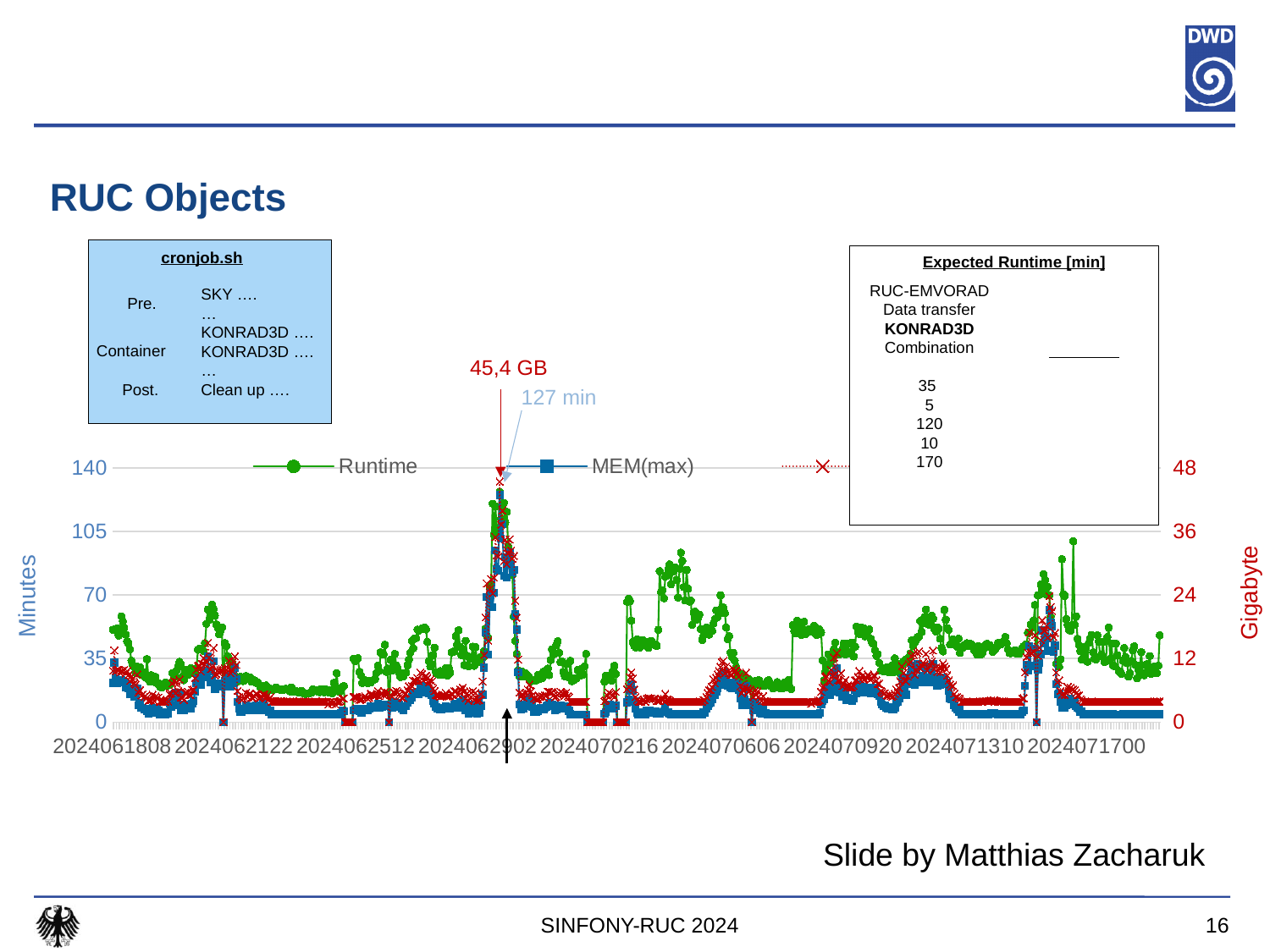
Is the peak MEM(max) value greater or less than 36 gigabytes? greater What is the highest tick value on the left (Minutes) axis? 140 What kind of chart is shown on the slide? line chart What unit is shown on the left vertical axis? Minutes What is the annotated peak Runtime value marked on the chart? 127 min Which series is plotted with green circle markers? Runtime What is the highest tick value on the right (Gigabyte) axis? 48 Is the peak Runtime value greater or less than 105 minutes? greater What is the last date label on the x axis? 2024071700 What is the first date label on the x axis? 2024061808 How many date labels are shown along the x axis? 9 What is the annotated peak memory value marked on the chart? 45,4 GB